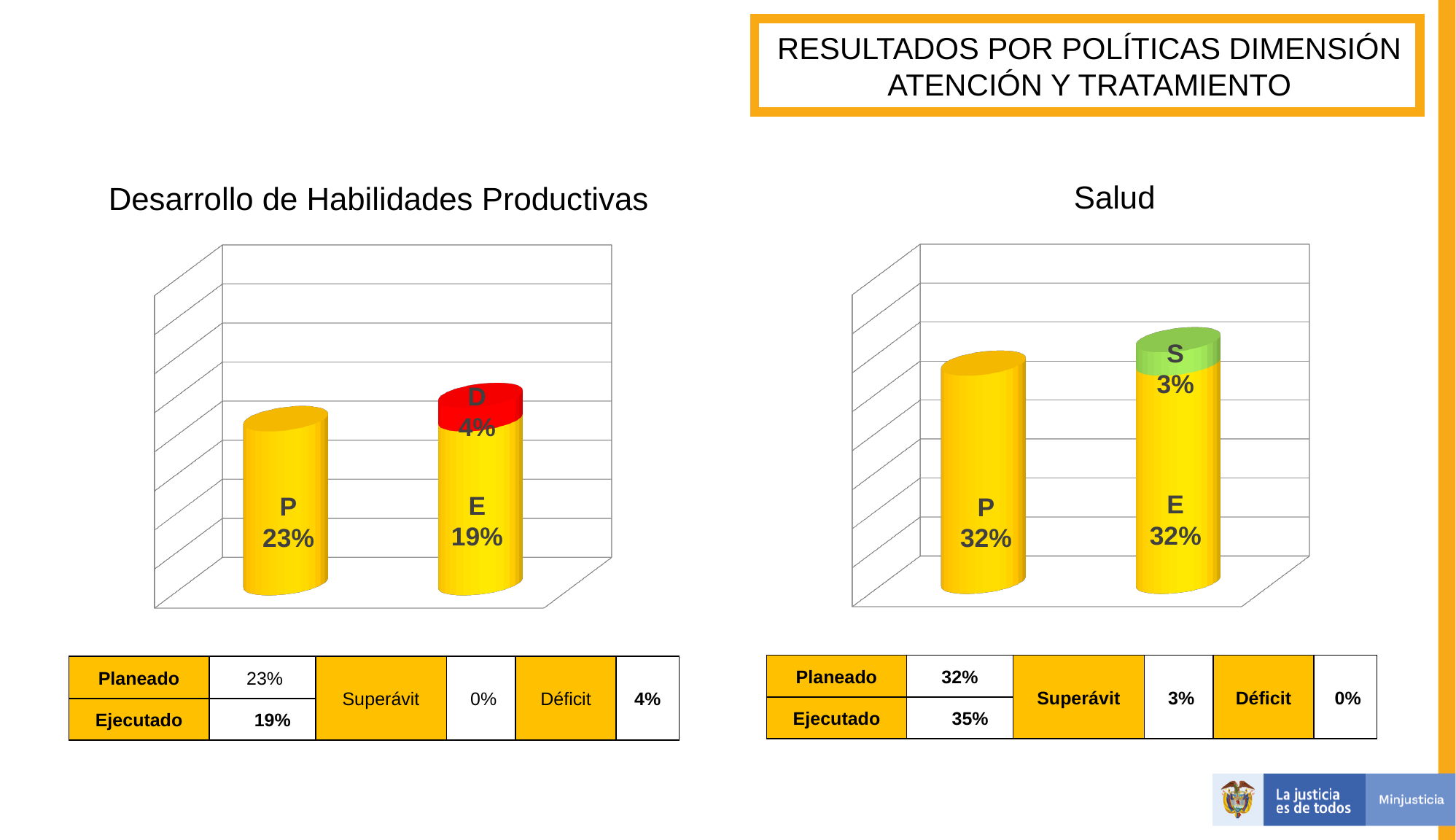
In the Desarrollo de Habilidades Productivas chart, which is larger, the P value or the E value? P In the Desarrollo de Habilidades Productivas chart, what value is shown for the red segment labelled D? 4% In the Salud chart, what is the total of the stacked E bar (E plus S)? 35% In the Desarrollo de Habilidades Productivas chart, what is the value labelled E? 19% What kind of chart is the Desarrollo de Habilidades Productivas chart? Bar chart How many bars are plotted in the Salud chart? 2 In the Desarrollo de Habilidades Productivas chart, what is the difference between the P value and the E value? 4% In the Desarrollo de Habilidades Productivas chart, what is the value labelled P? 23% In the Salud chart, what colour is the segment labelled S? Green In the Salud chart, what is the value labelled P? 32% In the Salud chart, what value is shown for the green segment labelled S? 3% In the Desarrollo de Habilidades Productivas chart, what is the total of the stacked E bar (E plus D)? 23%